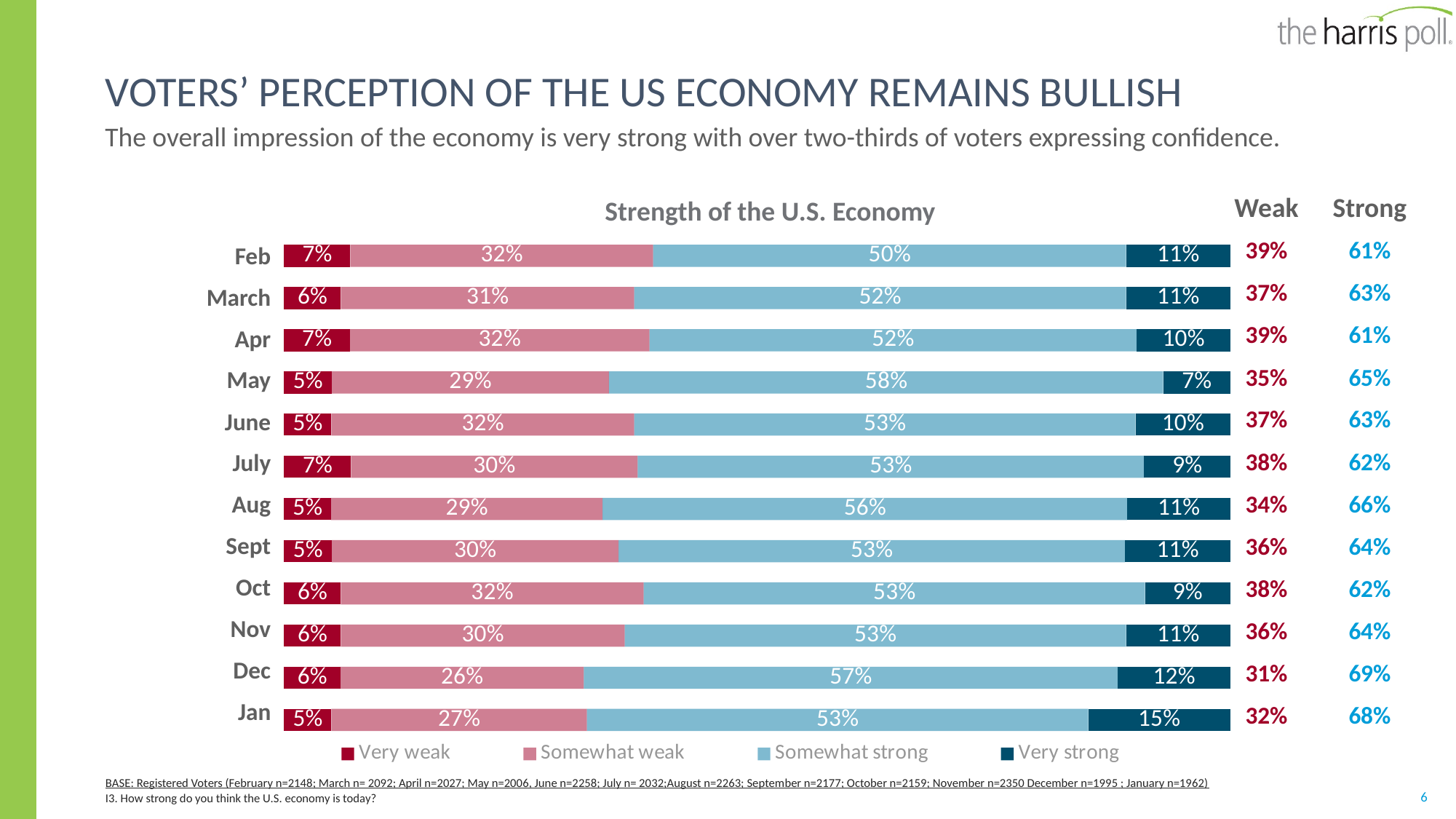
Which is larger, the Somewhat weak value for Feb or for Jan? Feb How many months are plotted in the chart? 12 What kind of chart is shown on the slide? Stacked bar chart What is the Somewhat strong value for May? 58% What is the Somewhat weak value for Dec? 26% What is the title of the chart? Strength of the U.S. Economy How many series does the legend list? 4 What is the difference between the Somewhat strong values for May and Feb? 8% Which month has the lowest Very strong value? May What is the Very weak value for Feb? 7% Which month has the highest Very strong value? Jan What is the total of the stacked bar for Feb? 100%